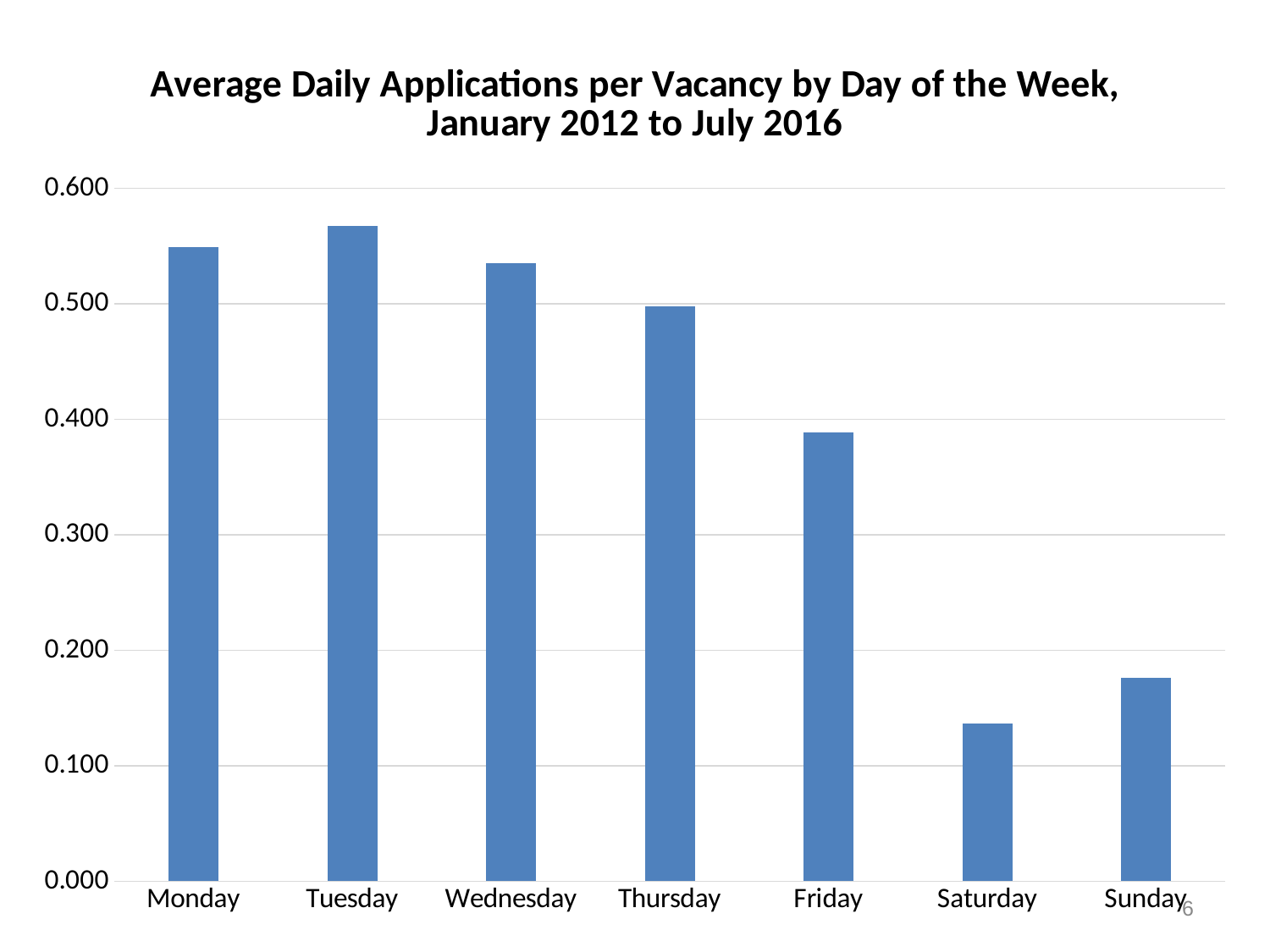
Is the value for Friday greater or less than 0.400? less Do the values rise or fall from Tuesday through Saturday? fall Which has a higher value, Monday or Friday? Monday What is the title of the chart? Average Daily Applications per Vacancy by Day of the Week, January 2012 to July 2016 Which has a higher value, Saturday or Sunday? Sunday What kind of chart is shown on the slide? bar chart Which day of the week has the highest average daily applications per vacancy? Tuesday How many days of the week are plotted on the chart? 7 Is the value for Monday greater or less than 0.500? greater Is the value for Sunday greater or less than 0.200? less Which day of the week has the lowest average daily applications per vacancy? Saturday